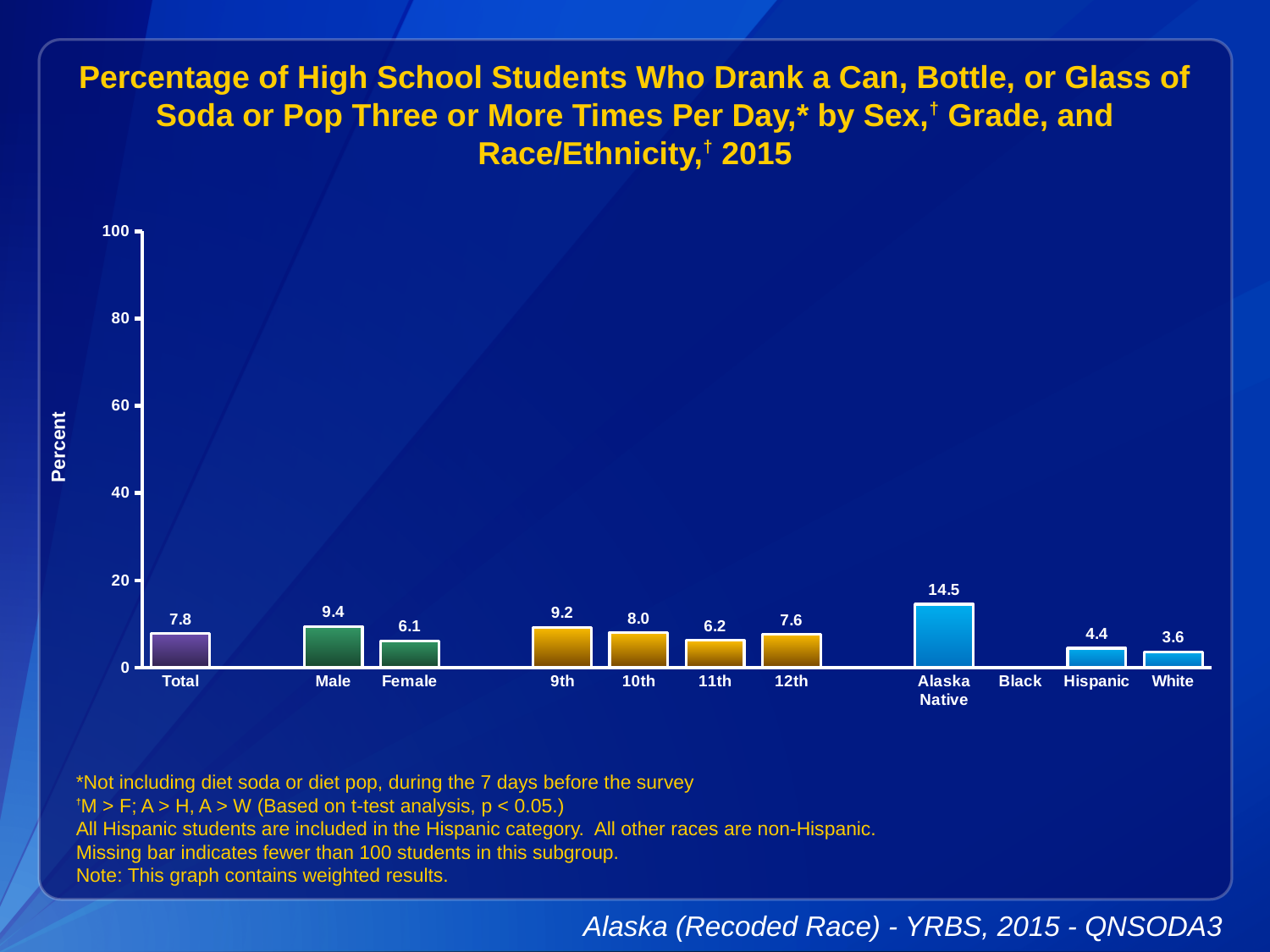
What is the difference between the Male and Female values? 3.3 What is the value for Total? 7.8 What is the value for 11th grade? 6.2 Which category has no bar shown? Black What kind of chart is shown? bar chart What is the value for Alaska Native? 14.5 Which is larger, the value for 9th grade or 12th grade? 9th How many categories are labeled on the x axis? 11 Which category with a plotted bar has the lowest value? White What is the value for Male? 9.4 Which category has the highest value? Alaska Native Is the value for Alaska Native greater or less than 20? less